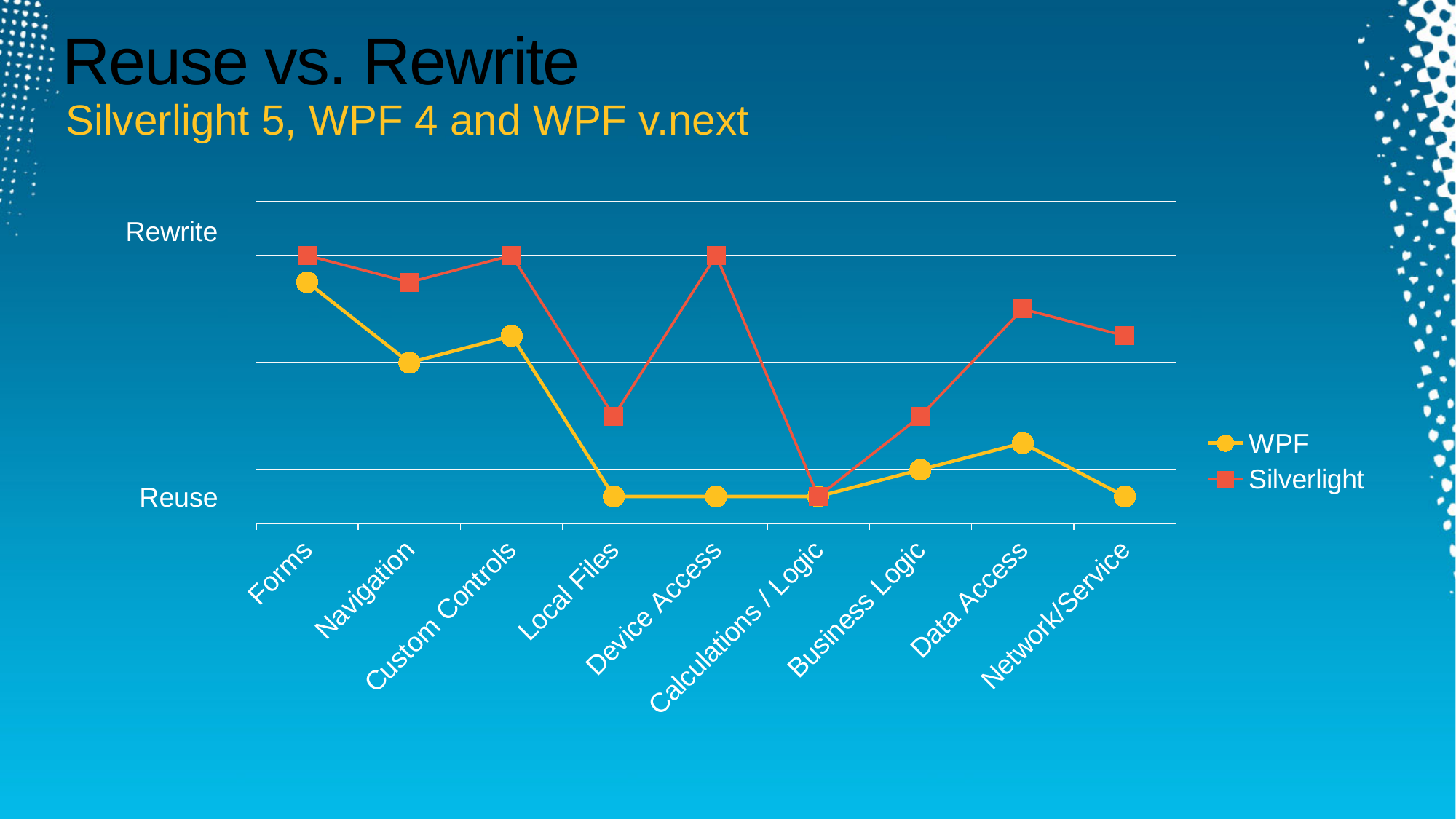
How many series does the legend list? 2 How many categories are plotted along the x axis? 9 What are the two labels shown on the vertical axis? Rewrite and Reuse Which series are listed in the legend? WPF and Silverlight For which category is the Silverlight series closest to Reuse (lowest)? Calculations / Logic For which category is the WPF series closest to Rewrite (highest)? Forms At Device Access, which series is closer to Rewrite, WPF or Silverlight? Silverlight At Network/Service, which series is closer to Rewrite, WPF or Silverlight? Silverlight At Forms, which series is closer to Rewrite, WPF or Silverlight? Silverlight What kind of chart is shown on the slide? Line chart Does the Silverlight series rise or fall from Calculations / Logic to Data Access? Rise Does the WPF series rise or fall from Forms to Local Files? Fall